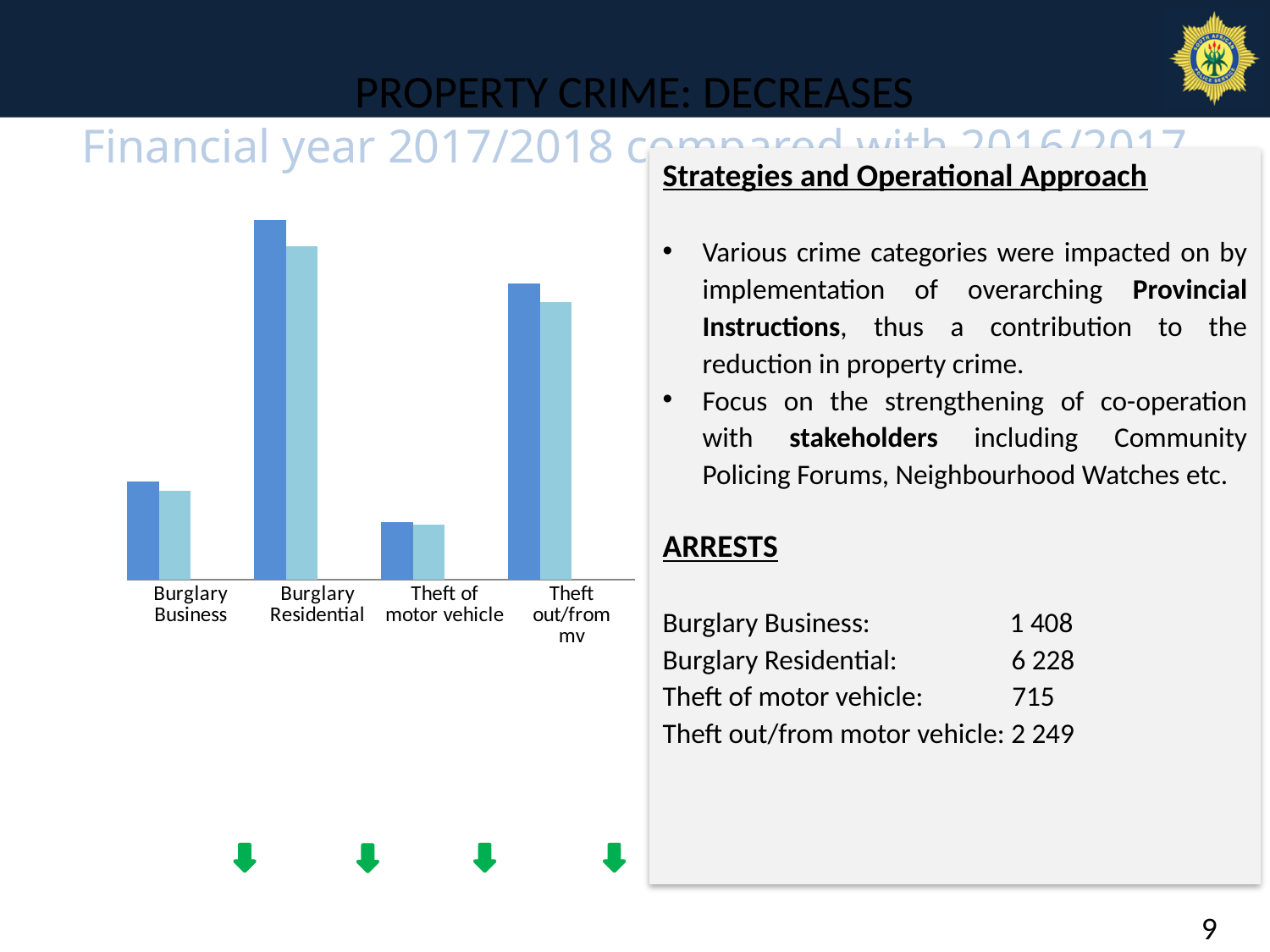
How many bars are plotted for each category in the chart? 2 What is the title shown above the chart? PROPERTY CRIME: DECREASES Which category has the shortest bars in the chart? Theft of motor vehicle For Burglary Residential, is the dark blue bar taller or shorter than the light blue bar? taller For Burglary Business, is the light blue bar taller or shorter than the dark blue bar? shorter Which category has taller bars: Burglary Residential or Theft out/from mv? Burglary Residential Which category has the tallest bars in the chart? Burglary Residential How many categories are shown on the x axis of the chart? 4 What kind of chart is shown on the slide? bar chart